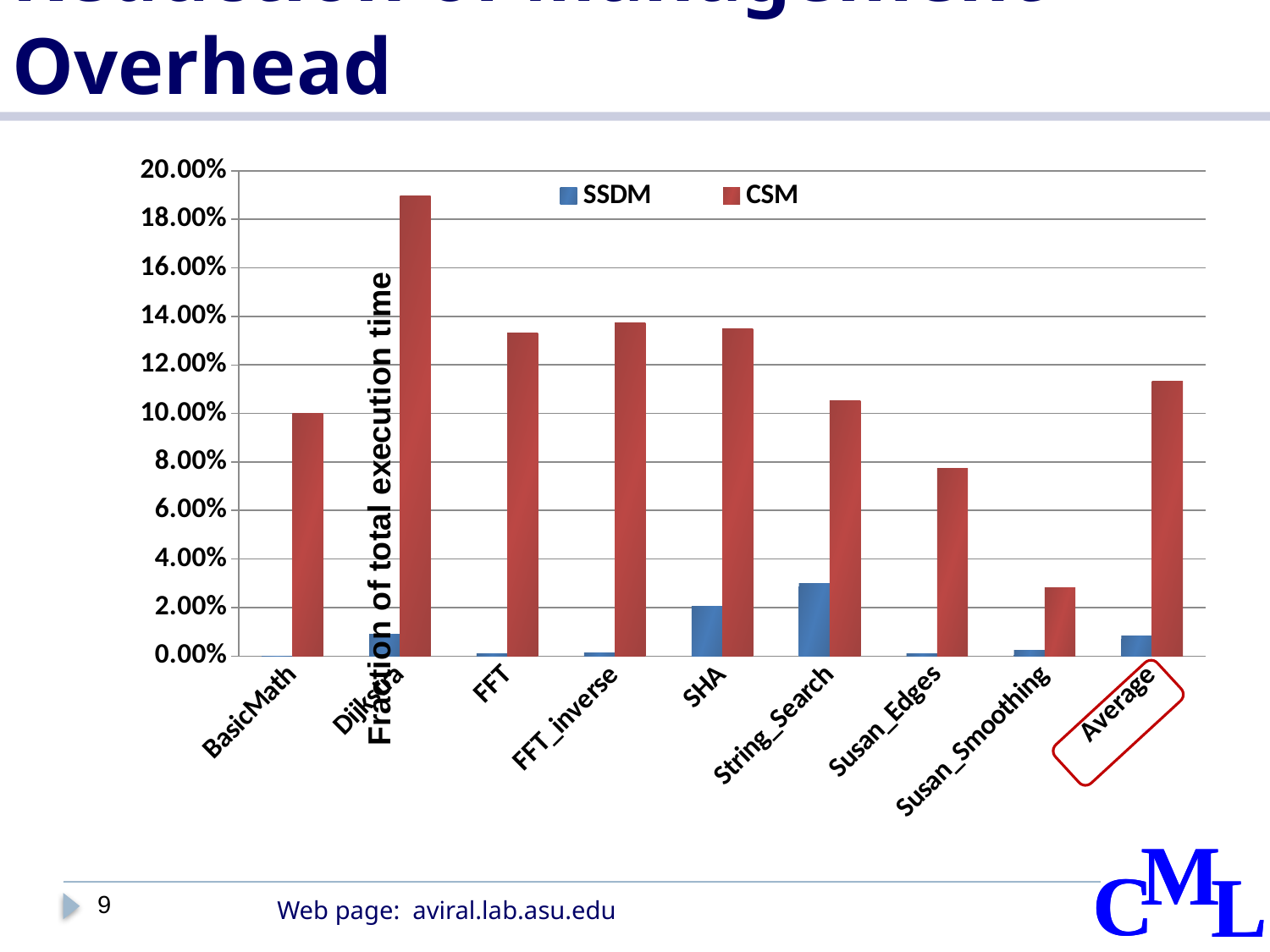
What kind of chart is shown on the slide? bar chart Is the CSM value for Susan_Edges greater or less than 8.00%? less Is the SSDM value for String_Search greater or less than 2.00%? greater Which category has the highest SSDM value? String_Search How many categories are shown along the x axis? 9 How many series does the legend list? 2 Which category has the lowest CSM value? Susan_Smoothing Which category has the highest CSM value? Dijkstra For SHA, which series has the larger value, SSDM or CSM? CSM What is the label on the vertical axis of the chart? Fraction of total execution time Is the CSM value for Dijkstra greater or less than 18.00%? greater